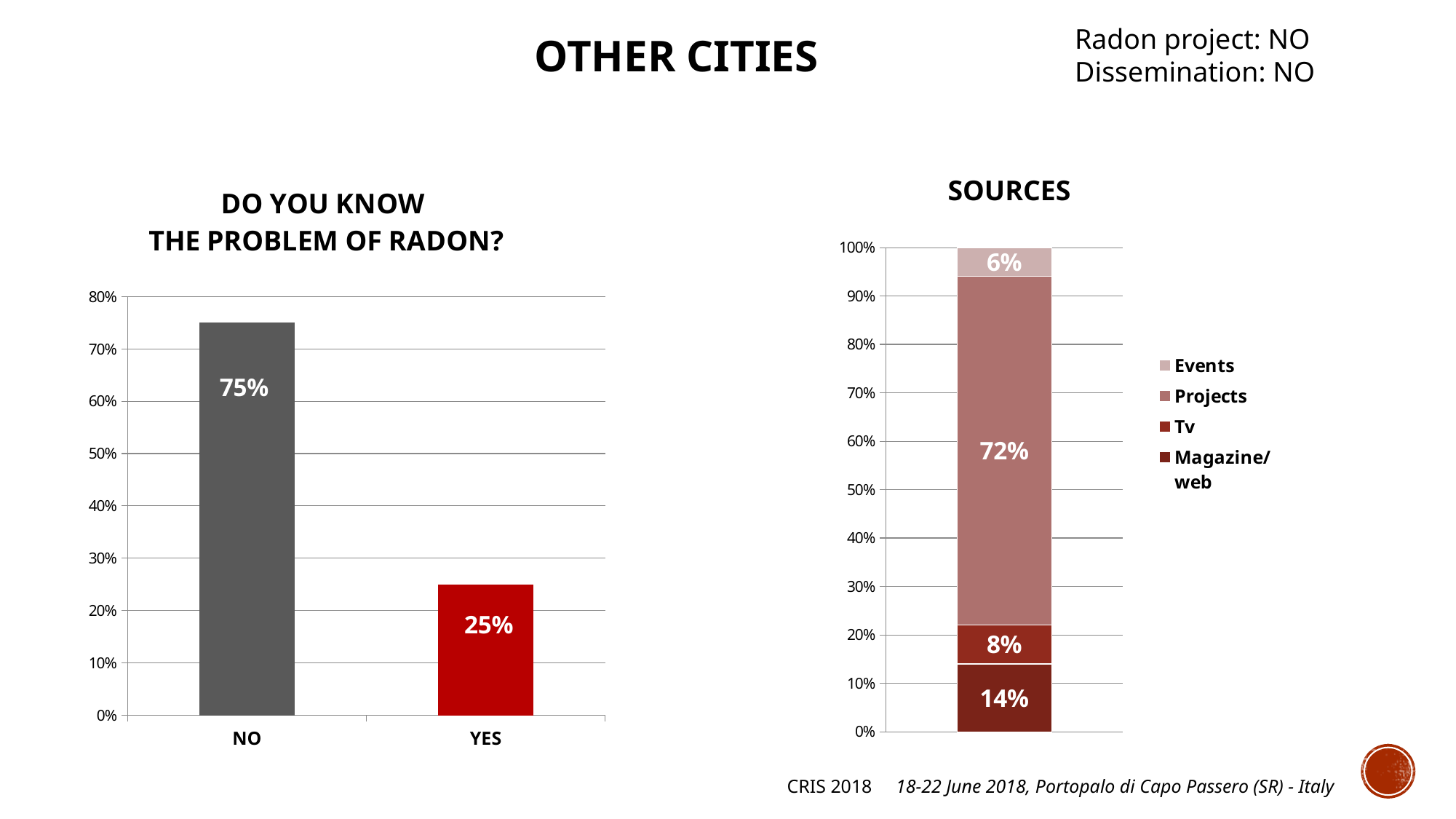
What kind of chart is the 'DO YOU KNOW THE PROBLEM OF RADON?' chart? Bar chart In the SOURCES chart, how many series does the legend list? 4 In the SOURCES chart, which source has the lowest value? Events In the SOURCES chart, what is the value for Projects? 72% In the 'DO YOU KNOW THE PROBLEM OF RADON?' chart, which category has the highest value? NO In the 'DO YOU KNOW THE PROBLEM OF RADON?' chart, what is the difference between the NO and YES values? 50% In the 'DO YOU KNOW THE PROBLEM OF RADON?' chart, what is the value for NO? 75% In the SOURCES chart, is the value for Tv larger or smaller than the value for Magazine/web? Smaller In the 'DO YOU KNOW THE PROBLEM OF RADON?' chart, how many categories are shown on the x axis? 2 In the SOURCES chart, what is the value for Magazine/web? 14% In the 'DO YOU KNOW THE PROBLEM OF RADON?' chart, what is the value for YES? 25% In the SOURCES chart, what is the value for Tv? 8%